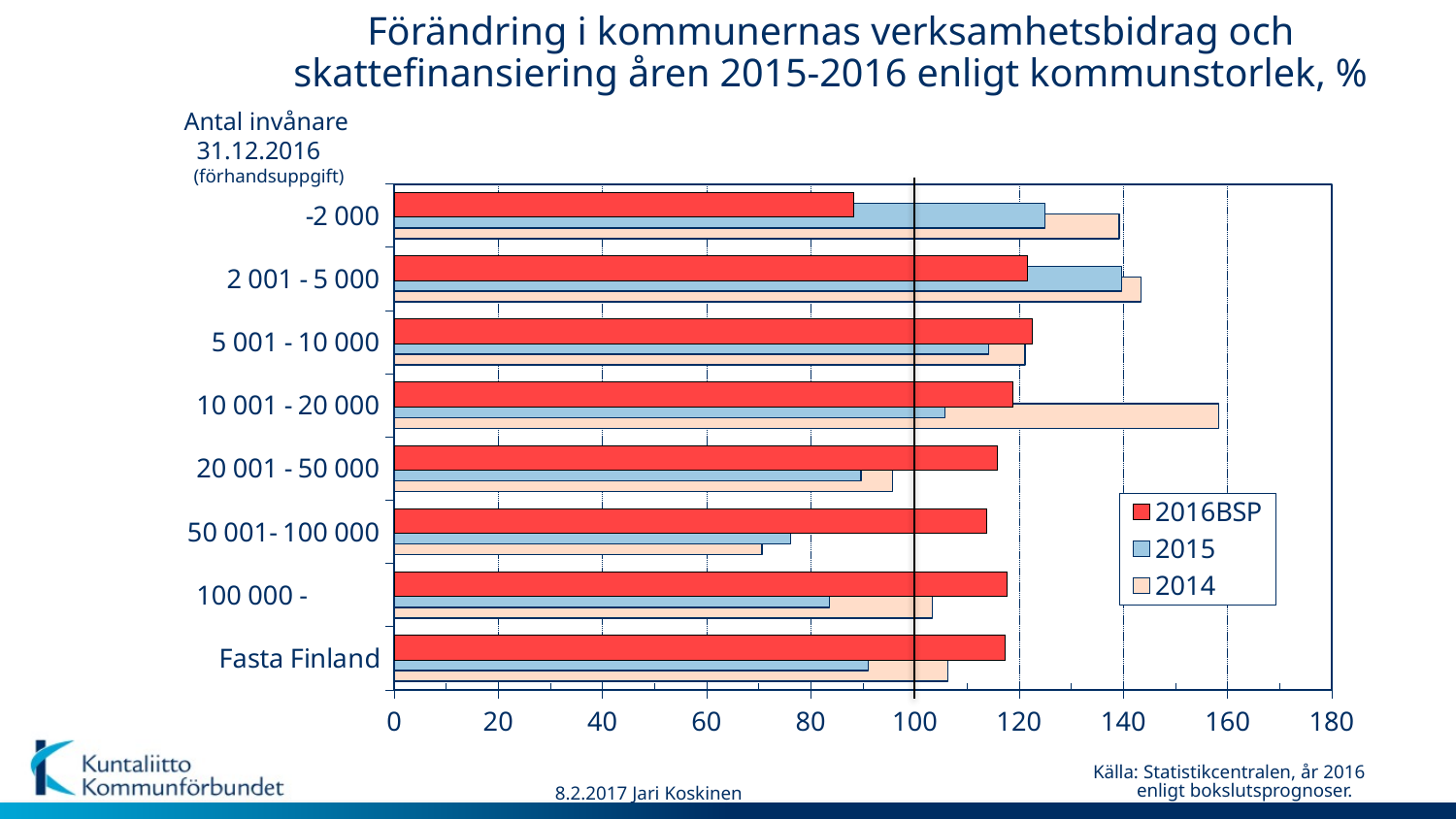
For the 20 001 - 50 000 category, which is larger: the 2016BSP value or the 2015 value? 2016BSP Is the 2014 value for the 50 001- 100 000 category greater or less than 80? less How many municipality size categories are shown on the vertical axis? 8 Is the 2016BSP value for the -2 000 category greater or less than 100? less For the -2 000 category, which is larger: the 2015 value or the 2016BSP value? 2015 Which category has the highest value for the 2014 series? 10 001 - 20 000 What kind of chart is shown on the slide? bar chart Is the 2014 value for the 10 001 - 20 000 category greater or less than 140? greater Which category has the lowest value for the 2016BSP series? -2 000 Which category has the lowest value for the 2015 series? 50 001- 100 000 How many series does the legend list? 3 What is the maximum value shown on the horizontal axis? 180